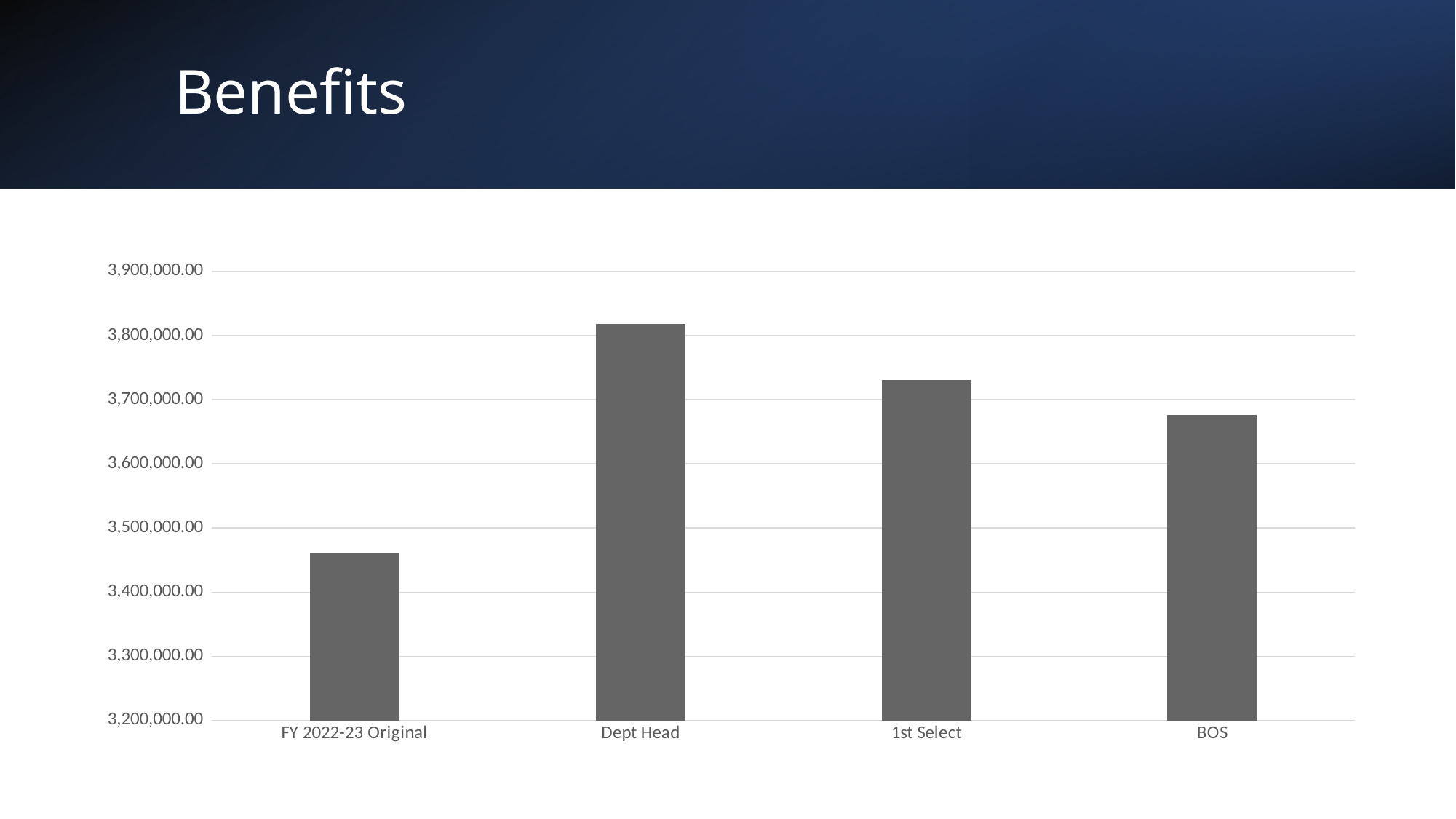
Is the value for 1st Select greater or less than 3,700,000.00? greater What kind of chart is shown on the slide? bar chart Which category has the highest bar in the chart? Dept Head Is the value for FY 2022-23 Original greater or less than 3,400,000.00? greater Which is larger, the value for Dept Head or the value for FY 2022-23 Original? Dept Head Is the value for Dept Head greater or less than 3,800,000.00? greater Which category has the lowest bar in the chart? FY 2022-23 Original Which is larger, the value for 1st Select or the value for BOS? 1st Select How many categories are shown on the x axis of the chart? 4 What is the title of the slide containing the chart? Benefits